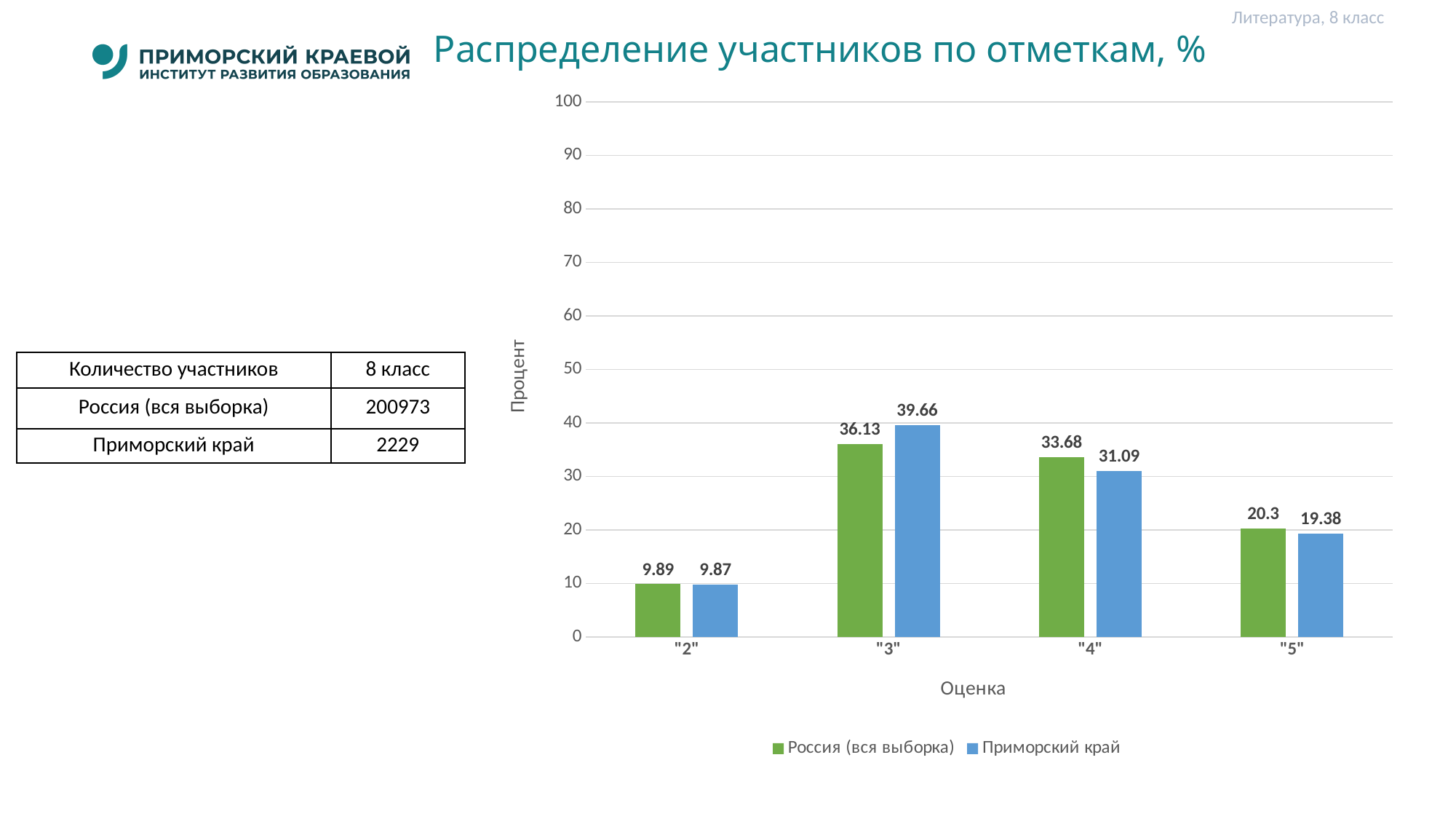
What is the difference between Приморский край and Россия (вся выборка) at grade "3"? 3.53 How many series does the legend list? 2 Which grade has the lowest value for Приморский край? "2" Which is larger at grade "4": Россия (вся выборка) or Приморский край? Россия (вся выборка) Which grade has the highest value for Россия (вся выборка)? "3" What is the difference between Россия (вся выборка) and Приморский край at grade "4"? 2.59 What is the label of the y axis? Процент What is the value for Приморский край at grade "5"? 19.38 What is the value for Россия (вся выборка) at grade "4"? 33.68 What is the value for Приморский край at grade "3"? 39.66 What kind of chart is shown on the slide? Bar chart How many grade categories are shown on the x axis? 4